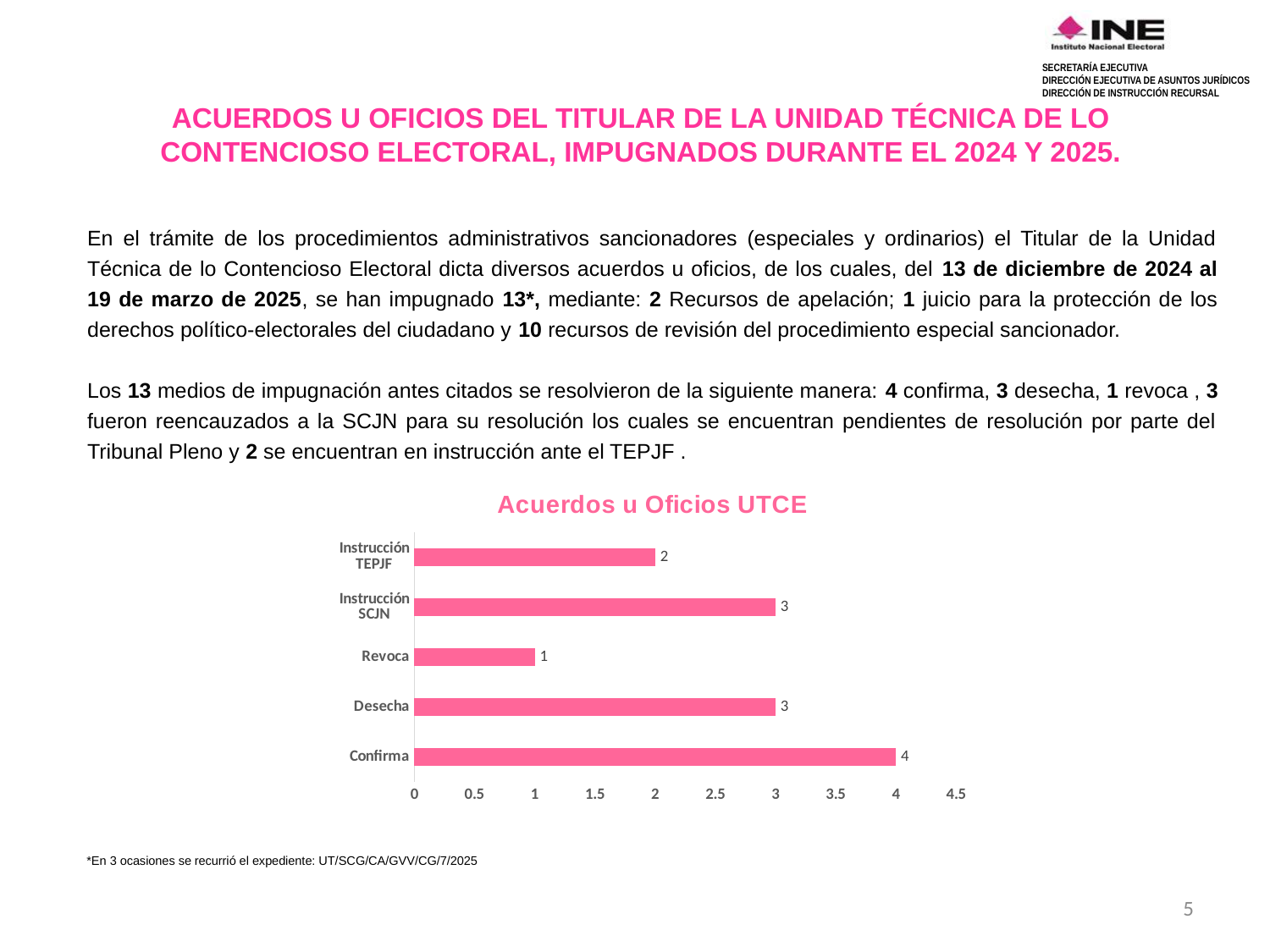
How many categories are shown in the chart? 5 What is the value for Instrucción SCJN in the chart? 3 What kind of chart is shown on the slide? Bar chart Which category has the highest value in the chart? Confirma What is the total of all the values shown in the chart? 13 What is the value for Instrucción TEPJF in the chart? 2 What is the difference between the values for Confirma and Desecha? 1 Which category has the lowest value in the chart? Revoca What is the title of the chart? Acuerdos u Oficios UTCE What is the value for Confirma in the chart? 4 Which is larger, the value for Instrucción SCJN or the value for Instrucción TEPJF? Instrucción SCJN What is the value for Revoca in the chart? 1